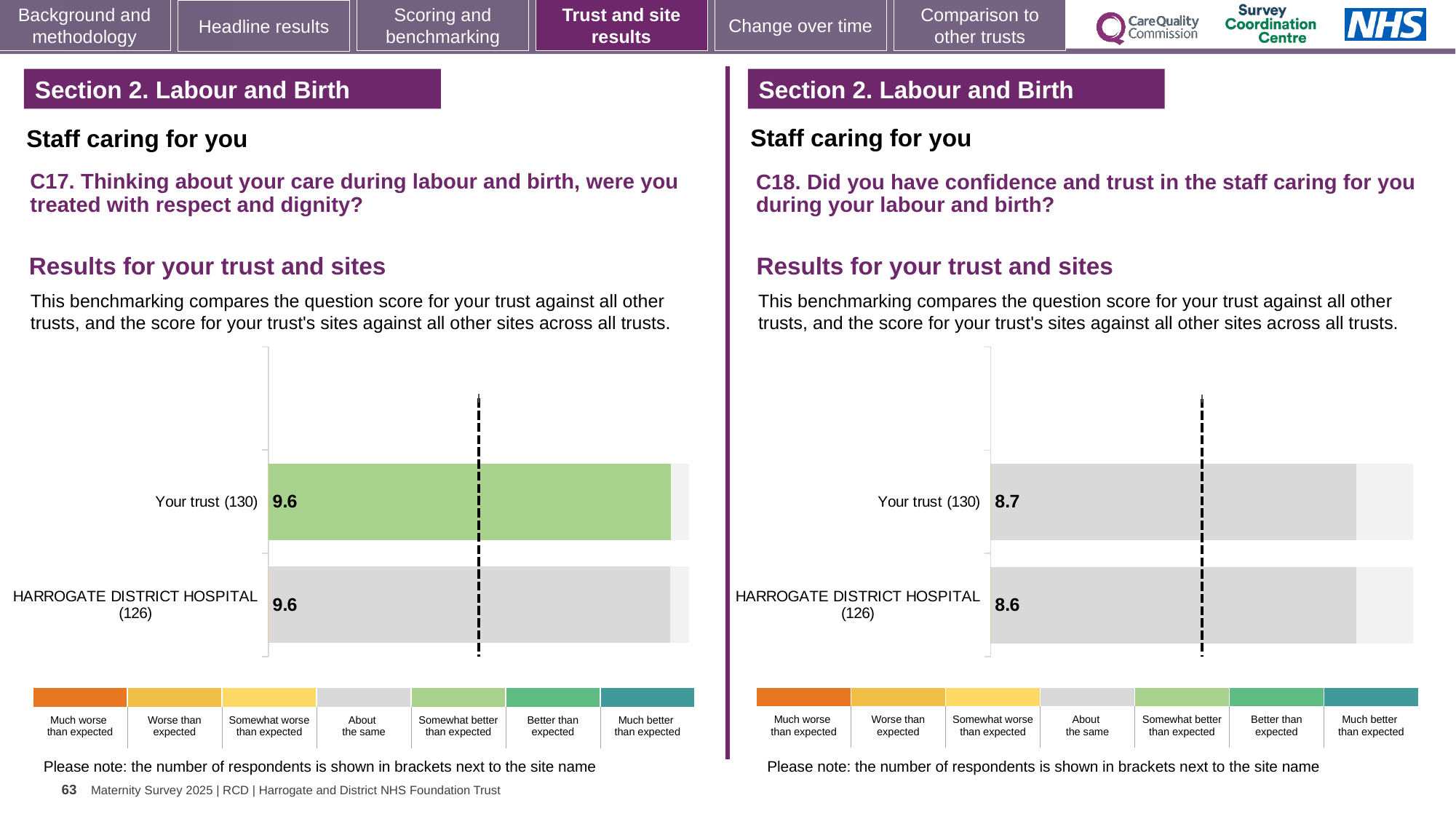
What type of chart is used on the C17 chart (left)? Bar chart On the C18 chart (right), what is the difference between the Your trust score and the HARROGATE DISTRICT HOSPITAL score? 0.1 On the C18 chart (right), how many bars are plotted? 2 On the C17 chart (left), how many bars are plotted? 2 On the C18 chart (right), which has the higher score, Your trust or HARROGATE DISTRICT HOSPITAL? Your trust On the C17 chart (left), how many respondents are shown in brackets for HARROGATE DISTRICT HOSPITAL? 126 On the C18 chart (right), what is the score for HARROGATE DISTRICT HOSPITAL (126)? 8.6 On the C17 chart (left), what colour is the bar for Your trust (130)? Green On the C17 chart (left), what is the score for HARROGATE DISTRICT HOSPITAL (126)? 9.6 On the C17 chart (left), what is the score for Your trust (130)? 9.6 On the C18 chart (right), what is the score for Your trust (130)? 8.7 On the C18 chart (right), what colour is the bar for Your trust (130)? Grey